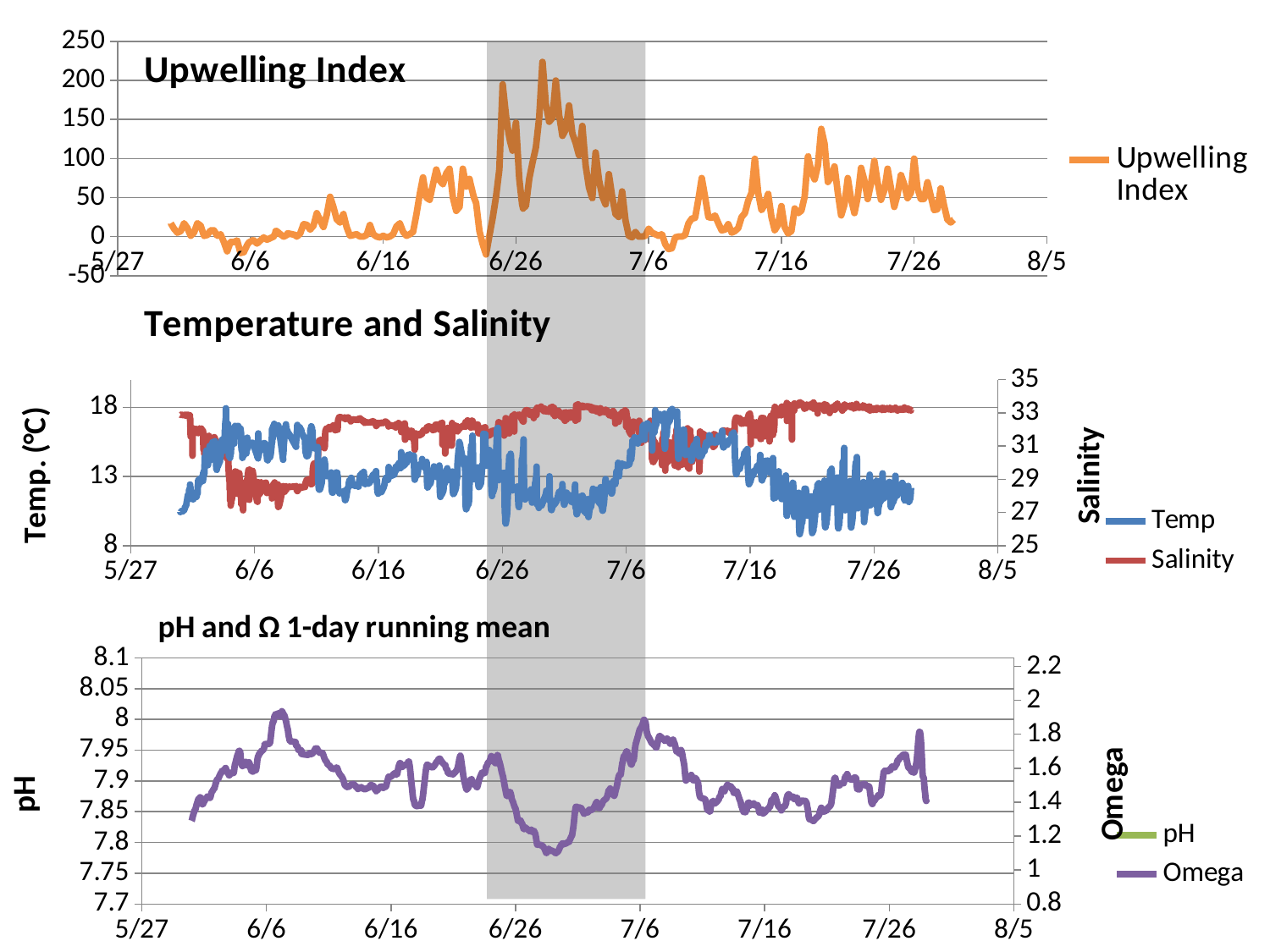
In the Temperature and Salinity chart, is the Temp value around 7/20 greater or less than 13? less In the pH and Ω 1-day running mean chart, is the lowest Omega value in the shaded period greater or less than 1.2? less How many series does the legend of the Temperature and Salinity chart list? 2 In the Upwelling Index chart, is the peak value reached shortly after 6/26 greater or less than 200? greater In the Temperature and Salinity chart, which series is plotted in blue? Temp How many series does the legend of the pH and Ω 1-day running mean chart list? 2 In the Temperature and Salinity chart, does the Temp series rise or fall between 6/26 and 7/6? rise What is the label on the left vertical axis of the Temperature and Salinity chart? Temp. (°C) How many series does the legend of the Upwelling Index chart list? 1 What kind of chart is the Upwelling Index chart? line chart